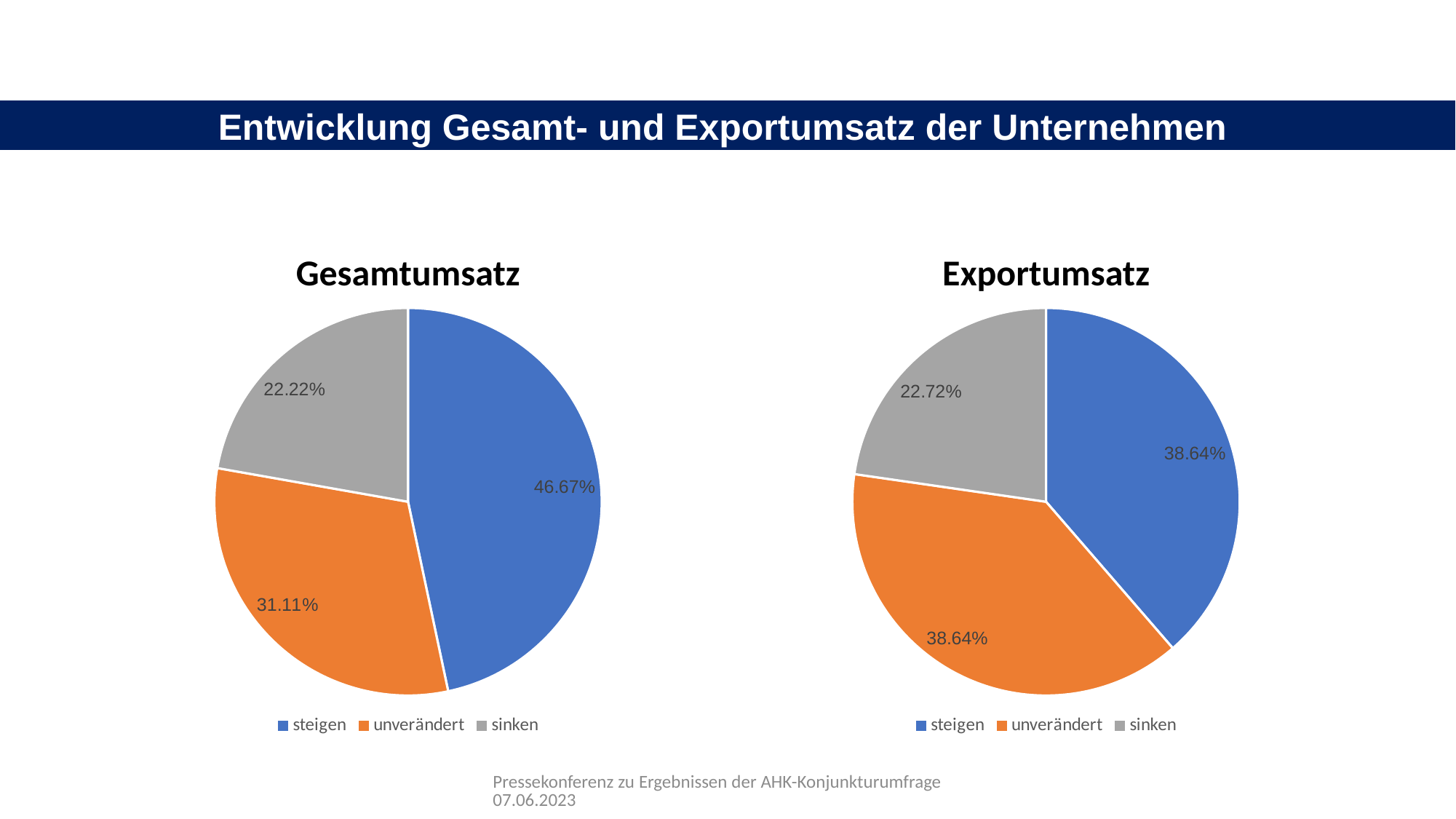
What type of chart is used for Gesamtumsatz and Exportumsatz? Pie chart In the Exportumsatz chart, what is the value for steigen? 38.64% In the Gesamtumsatz chart, what share of companies expect their total revenue to rise (steigen)? 46.67% How many categories does the legend of the Exportumsatz chart list? 3 In the Exportumsatz chart, what is the difference in percentage points between unverändert and sinken? 15.92 percentage points In the Gesamtumsatz chart, which category has the largest slice? steigen In the Exportumsatz chart, which category has the smallest slice? sinken In the Gesamtumsatz chart, what is the value for unverändert? 31.11% In the Gesamtumsatz chart, which is larger: the slice for unverändert or the slice for sinken? unverändert In the Gesamtumsatz chart, what is the difference in percentage points between steigen and unverändert? 15.56 percentage points In the Gesamtumsatz chart, which category has the smallest slice? sinken In the Exportumsatz chart, what is the value for sinken? 22.72%